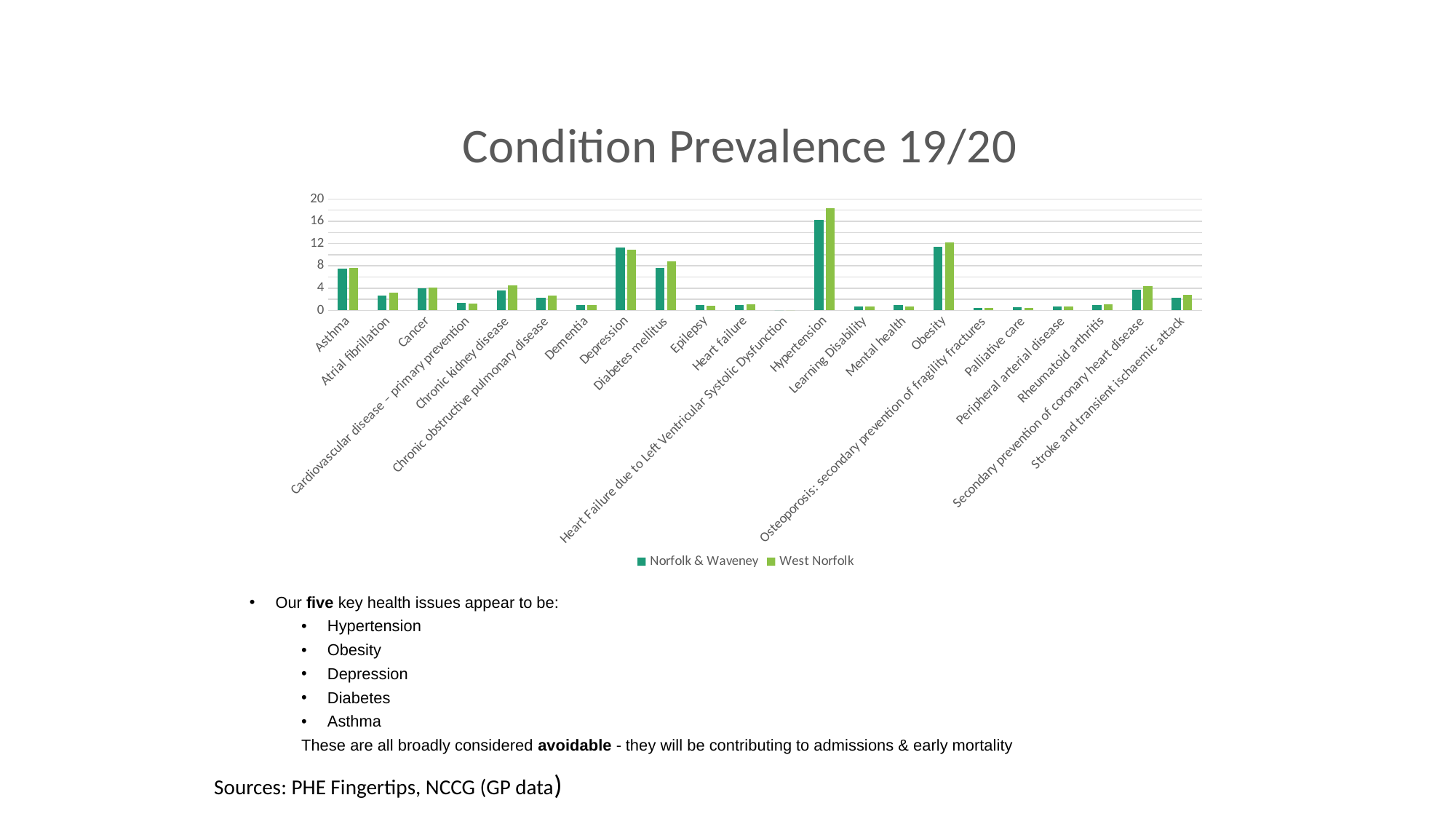
What type of chart is shown on the slide? bar chart Which two series are shown in the chart legend? Norfolk & Waveney and West Norfolk How many series does the chart legend list? 2 Which condition has the larger Norfolk & Waveney value: Depression or Asthma? Depression For Diabetes mellitus, which series has the larger value: Norfolk & Waveney or West Norfolk? West Norfolk Is the Norfolk & Waveney value for Asthma greater or less than 8? less Is the Norfolk & Waveney value for Depression greater or less than 8? greater Is the West Norfolk value for Hypertension greater or less than 16? greater Which condition has the highest prevalence in the chart? Hypertension How many conditions are shown along the x axis of the chart? 22 What is the title of the chart? Condition Prevalence 19/20 For Hypertension, which series has the larger value: Norfolk & Waveney or West Norfolk? West Norfolk